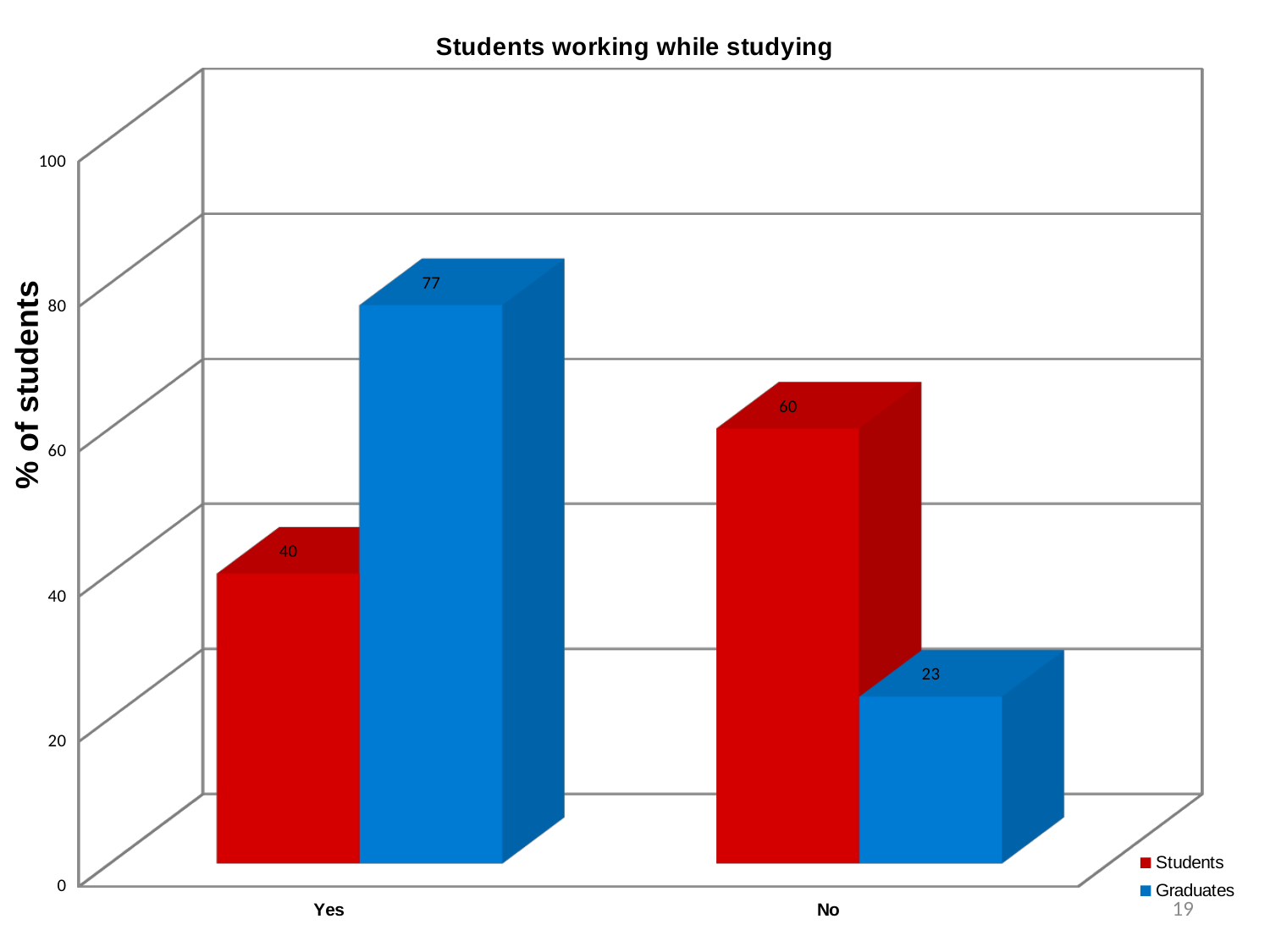
Which category has the lowest value for Students? Yes What is the value for Students in the Yes category? 40 In the No category, which series has the larger value, Students or Graduates? Students What is the difference between the Graduates and Students values in the Yes category? 37 Which category has the highest value for Graduates? Yes What is the value for Students in the No category? 60 How many categories are shown on the x axis? 2 What is the value for Graduates in the Yes category? 77 How many series does the legend list? 2 What is the value for Graduates in the No category? 23 What is the title of the chart? Students working while studying What kind of chart is shown on the slide? Bar chart